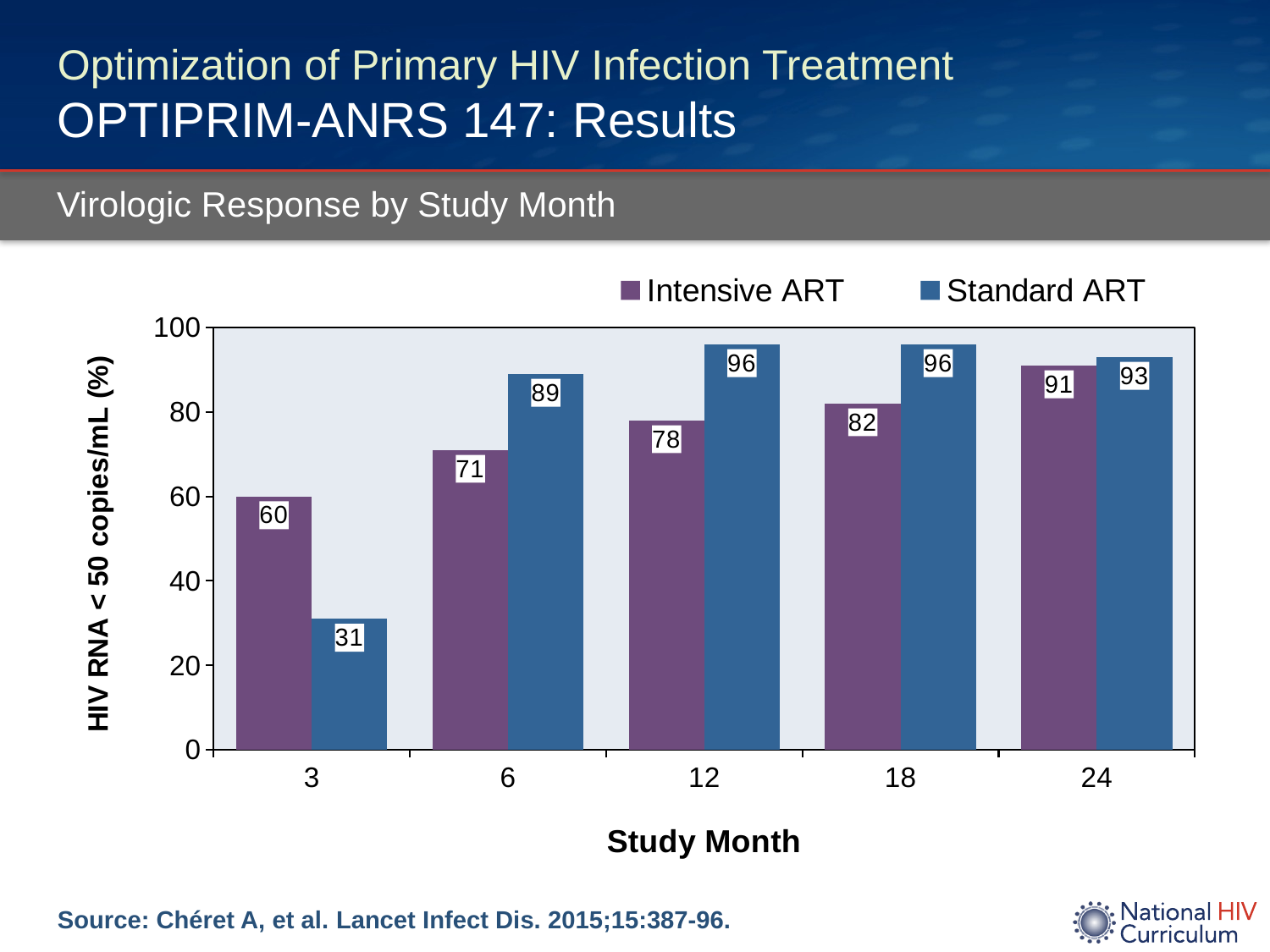
Which series has the larger value at study month 3, Intensive ART or Standard ART? Intensive ART Is the value for Intensive ART at study month 18 greater or less than 80? greater Do the Intensive ART values rise or fall from study month 3 to study month 24? Rise What is the value for Standard ART at study month 24? 93 What is the value for Intensive ART at study month 3? 60 What kind of chart is shown on the slide? Bar chart What is the value for Standard ART at study month 6? 89 At which study month is the Standard ART value lowest? 3 How many study months are shown on the x axis? 5 What is the difference between the Standard ART and Intensive ART values at study month 12? 18 At which study month is the Intensive ART value highest? 24 How many series does the legend list? 2